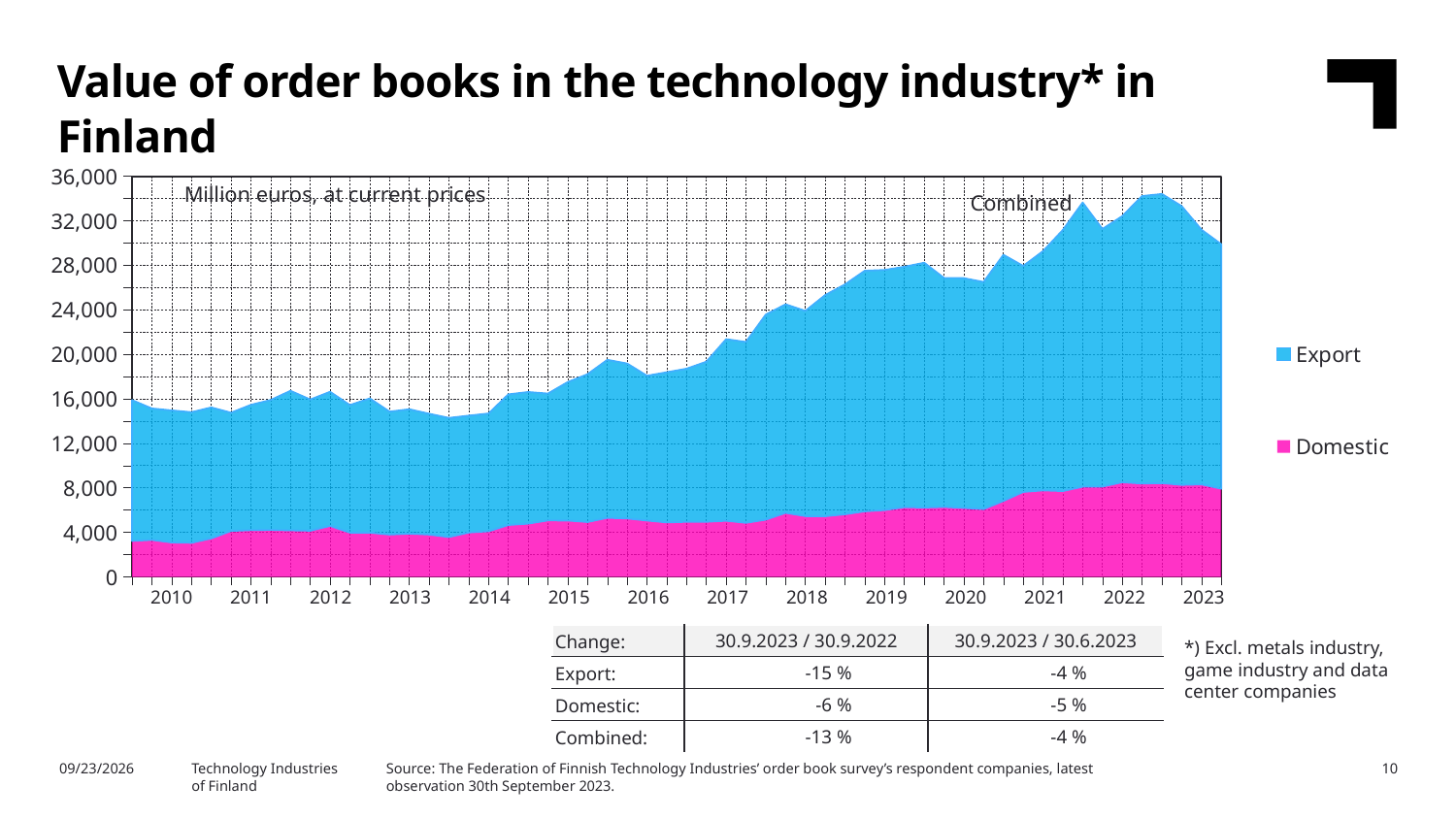
How many years are labeled on the x axis? 14 What unit is stated in the label at the top of the chart? Million euros, at current prices Is the combined value in 2019 greater or less than 24,000? greater Which two series are listed in the chart legend? Export and Domestic How many series does the legend list? 2 Does the combined value of order books generally rise or fall from 2010 to 2023? rise Which series is larger in 2023, Export or Domestic? Export In which year does the combined value reach its highest point? 2022 Is the combined value at the start of 2010 greater or less than 12,000? greater Is the combined value in 2016 greater or less than 20,000? less What kind of chart is shown on the slide? Area chart